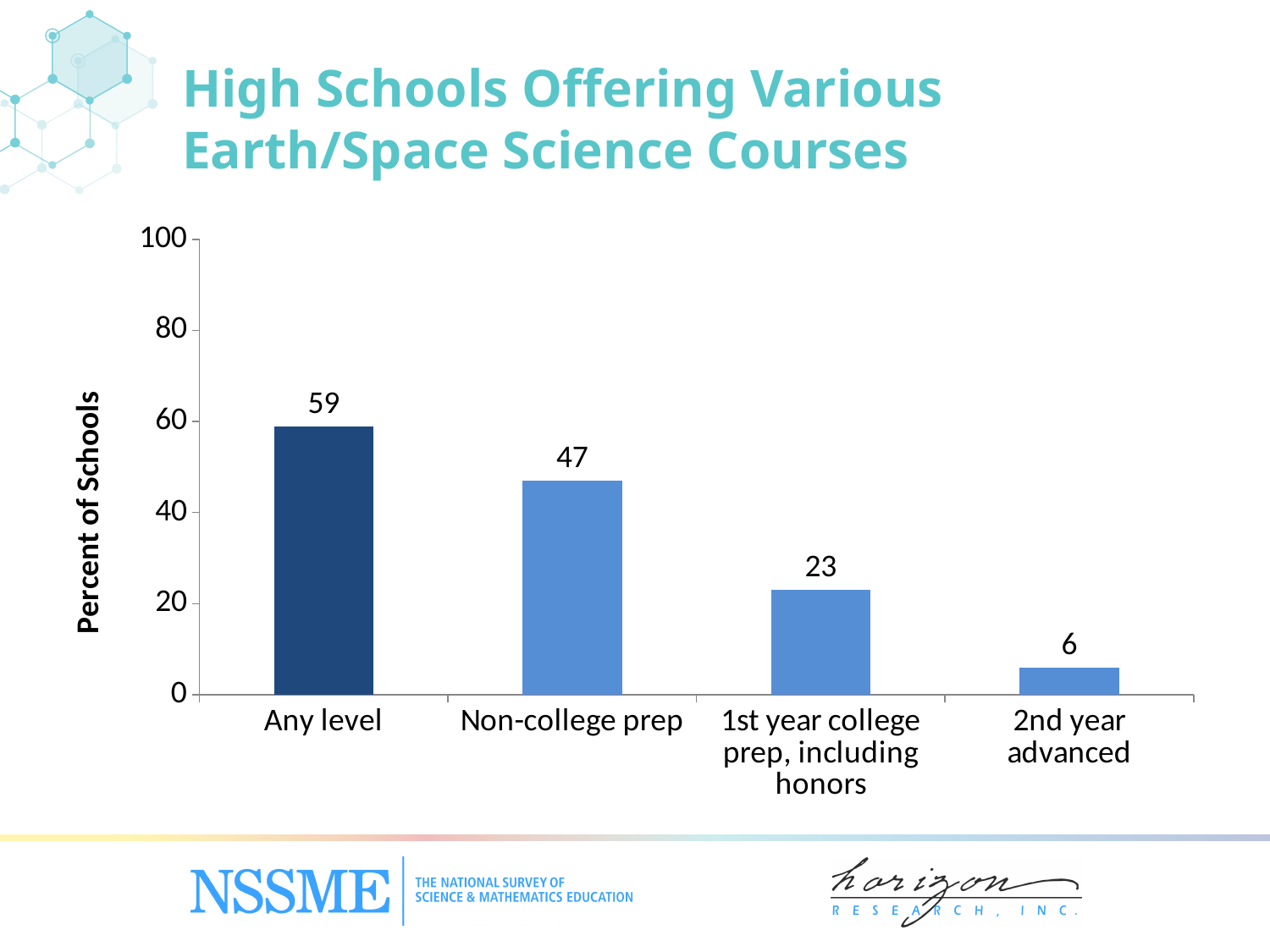
Which category has the highest percent of schools? Any level What is the value for 1st year college prep, including honors? 23 Which is larger, the value for Non-college prep or the value for 1st year college prep, including honors? Non-college prep What is the label of the y axis? Percent of Schools What is the value for Non-college prep? 47 Which category has the lowest percent of schools? 2nd year advanced What is the difference between the values for Any level and Non-college prep? 12 What is the value for 2nd year advanced? 6 What kind of chart is shown on the slide? Bar chart What percent of schools offer Earth/Space Science at any level? 59 How many categories are shown on the x axis? 4 What is the difference between the values for Non-college prep and 2nd year advanced? 41